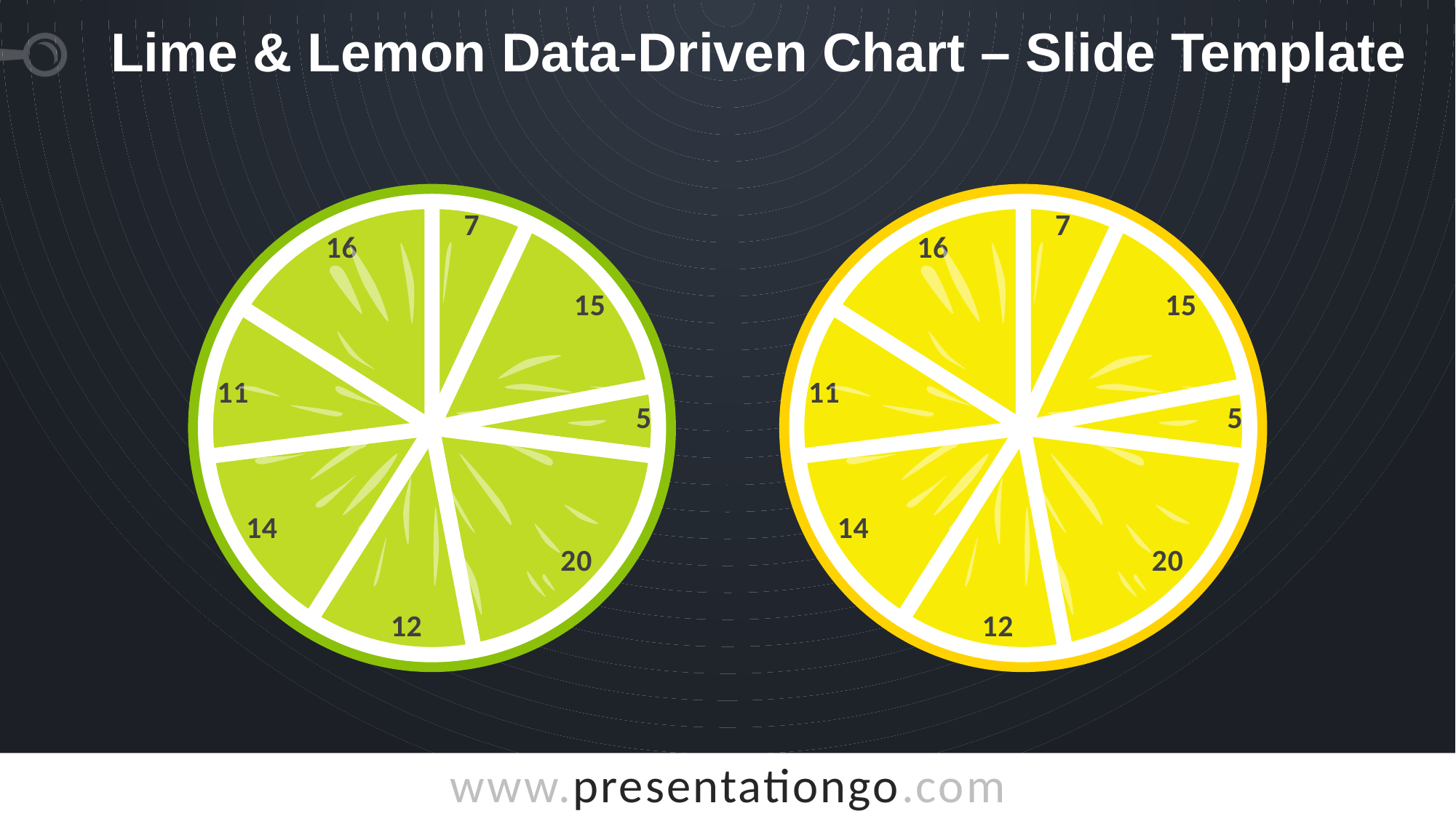
What is the title of the slide? Lime & Lemon Data-Driven Chart – Slide Template What colour is the pie chart on the left of the slide? Green In the lemon chart on the right, what is the difference between the largest and smallest slice values? 15 How many slices does the lemon chart on the right have? 8 In the lemon chart on the right, what is the smallest slice value? 5 What kind of chart is the lime chart on the left of the slide? Pie chart In the lime chart on the left, what share of the whole pie does the slice labelled 20 represent? 20% In the lime chart on the left, what is the largest slice value? 20 In the lemon chart on the right, what is the total of all the slice values? 100 In the lime chart on the left, which is larger, the slice labelled 16 or the slice labelled 14? 16 In the lime chart on the left, what is the difference between the slices labelled 15 and 7? 8 How many slices does the lime chart on the left have? 8